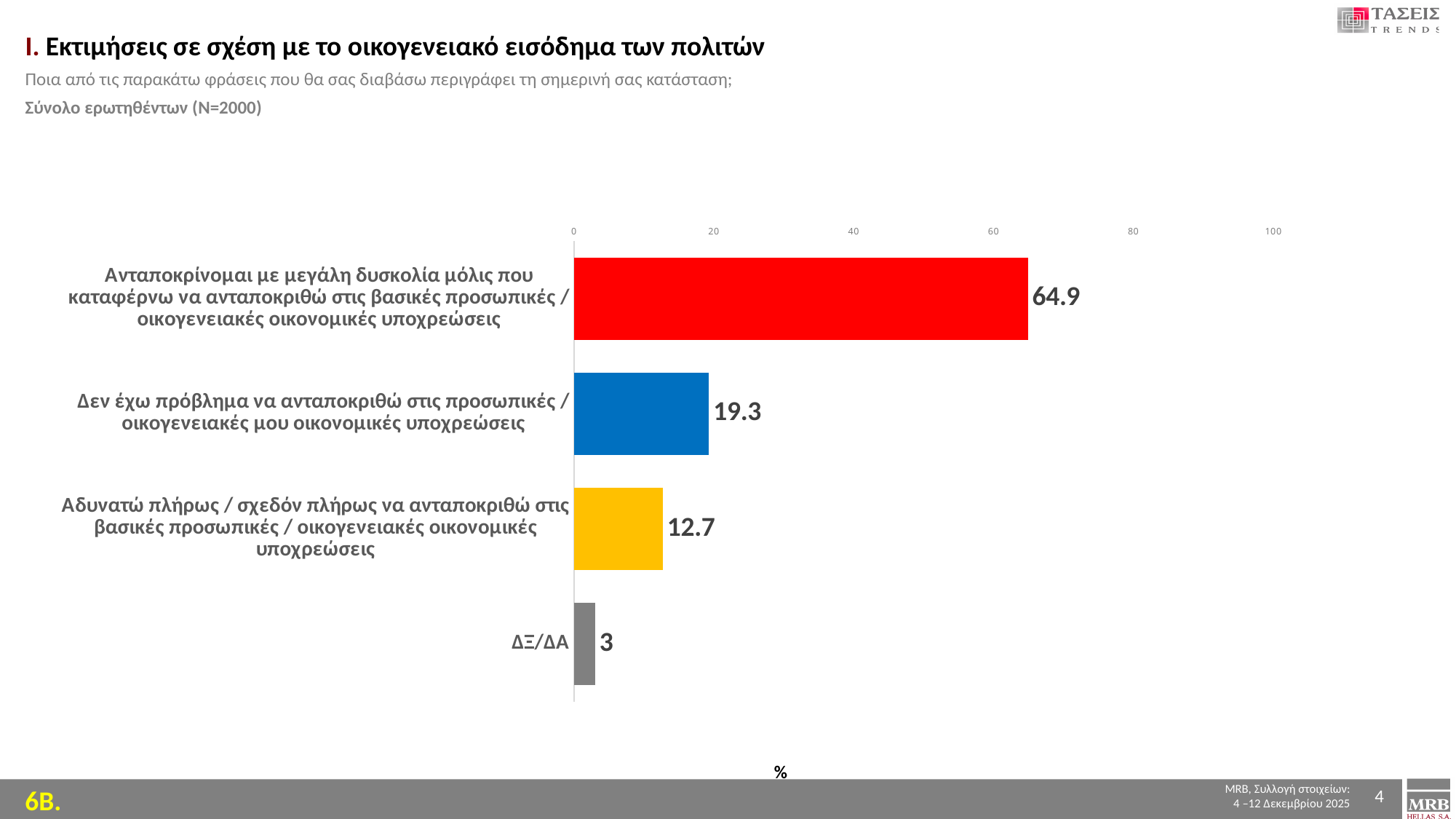
What kind of chart is shown on the slide? Bar chart What is the value for "Αδυνατώ πλήρως / σχεδόν πλήρως να ανταποκριθώ στις βασικές προσωπικές / οικογενειακές οικονομικές υποχρεώσεις"? 12.7 How many categories are shown in the chart? 4 What is the difference between the value for "Δεν έχω πρόβλημα να ανταποκριθώ..." and "Αδυνατώ πλήρως / σχεδόν πλήρως..."? 6.6 What is the value for "Ανταποκρίνομαι με μεγάλη δυσκολία μόλις που καταφέρνω να ανταποκριθώ στις βασικές προσωπικές / οικογενειακές οικονομικές υποχρεώσεις"? 64.9 Which category has the lowest value? ΔΞ/ΔΑ What is the value for "Δεν έχω πρόβλημα να ανταποκριθώ στις προσωπικές / οικογενειακές μου οικονομικές υποχρεώσεις"? 19.3 What is the value for ΔΞ/ΔΑ? 3 What is the difference between the value for "Ανταποκρίνομαι με μεγάλη δυσκολία..." (64.9) and "Δεν έχω πρόβλημα να ανταποκριθώ..." (19.3)? 45.6 Which category has the highest value? Ανταποκρίνομαι με μεγάλη δυσκολία μόλις που καταφέρνω να ανταποκριθώ στις βασικές προσωπικές / οικογενειακές οικονομικές υποχρεώσεις Is the value for "Ανταποκρίνομαι με μεγάλη δυσκολία..." greater or less than 60? greater Which is larger: the value for "Δεν έχω πρόβλημα να ανταποκριθώ..." or the value for "Αδυνατώ πλήρως / σχεδόν πλήρως..."? Δεν έχω πρόβλημα να ανταποκριθώ στις προσωπικές / οικογενειακές μου οικονομικές υποχρεώσεις